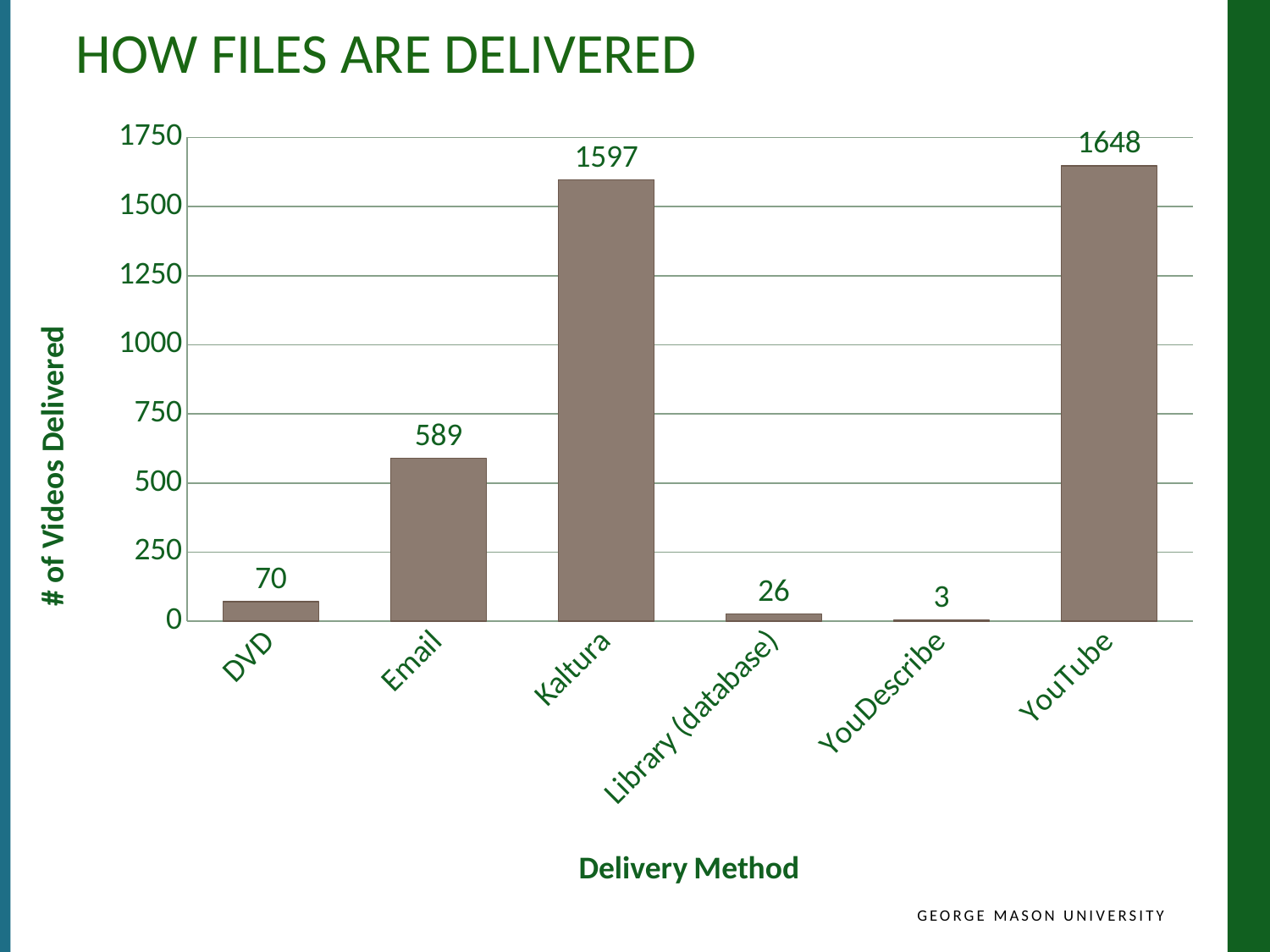
What is the label of the y-axis? # of Videos Delivered What is the difference between the number of videos delivered via YouTube and via Kaltura? 51 How many videos were delivered via Kaltura? 1597 What kind of chart is shown on the slide? Bar chart What is the difference between the number of videos delivered via DVD and via Library (database)? 44 How many delivery methods are shown on the chart? 6 How many videos were delivered via Email? 589 How many videos were delivered via YouDescribe? 3 Is the value for Email greater or less than 500? greater Which delivery method delivered more videos, Email or DVD? Email Which delivery method has the highest number of videos delivered? YouTube Which delivery method has the lowest number of videos delivered? YouDescribe